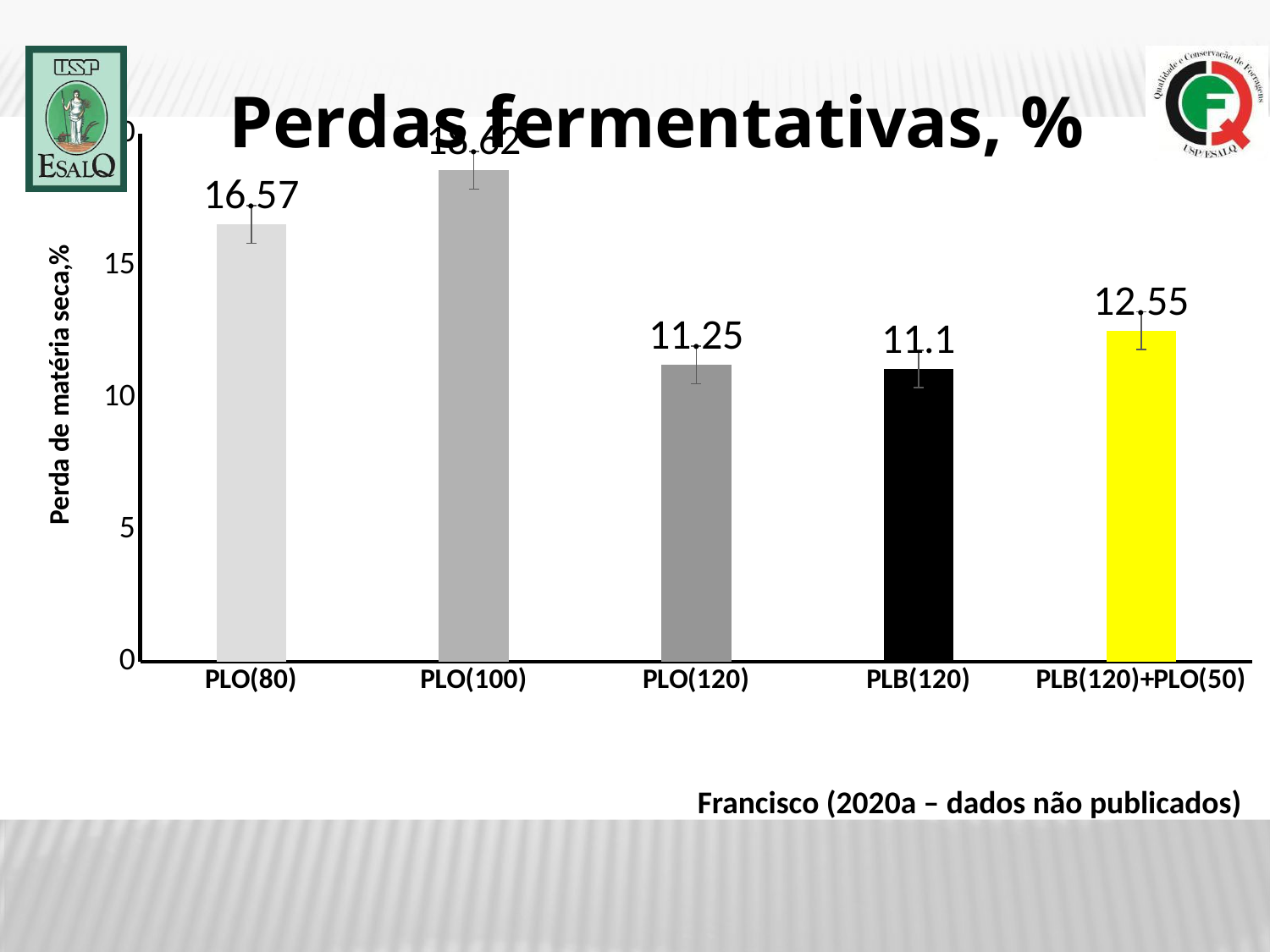
What is the value for PLO(80)? 16.57 Which is larger, the value for PLO(80) or the value for PLB(120)+PLO(50)? PLO(80) What is the difference between the values for PLB(120)+PLO(50) and PLB(120)? 1.45 How many categories are shown on the x axis? 5 What is the value for PLO(120)? 11.25 Which category has the highest value? PLO(100) What is the difference between the values for PLO(80) and PLO(120)? 5.32 Is the value for PLO(100) greater or less than 15? greater What is the value for PLB(120)? 11.1 What kind of chart is shown on the slide? bar chart What is the value for PLB(120)+PLO(50)? 12.55 Which category has the lowest value? PLB(120)